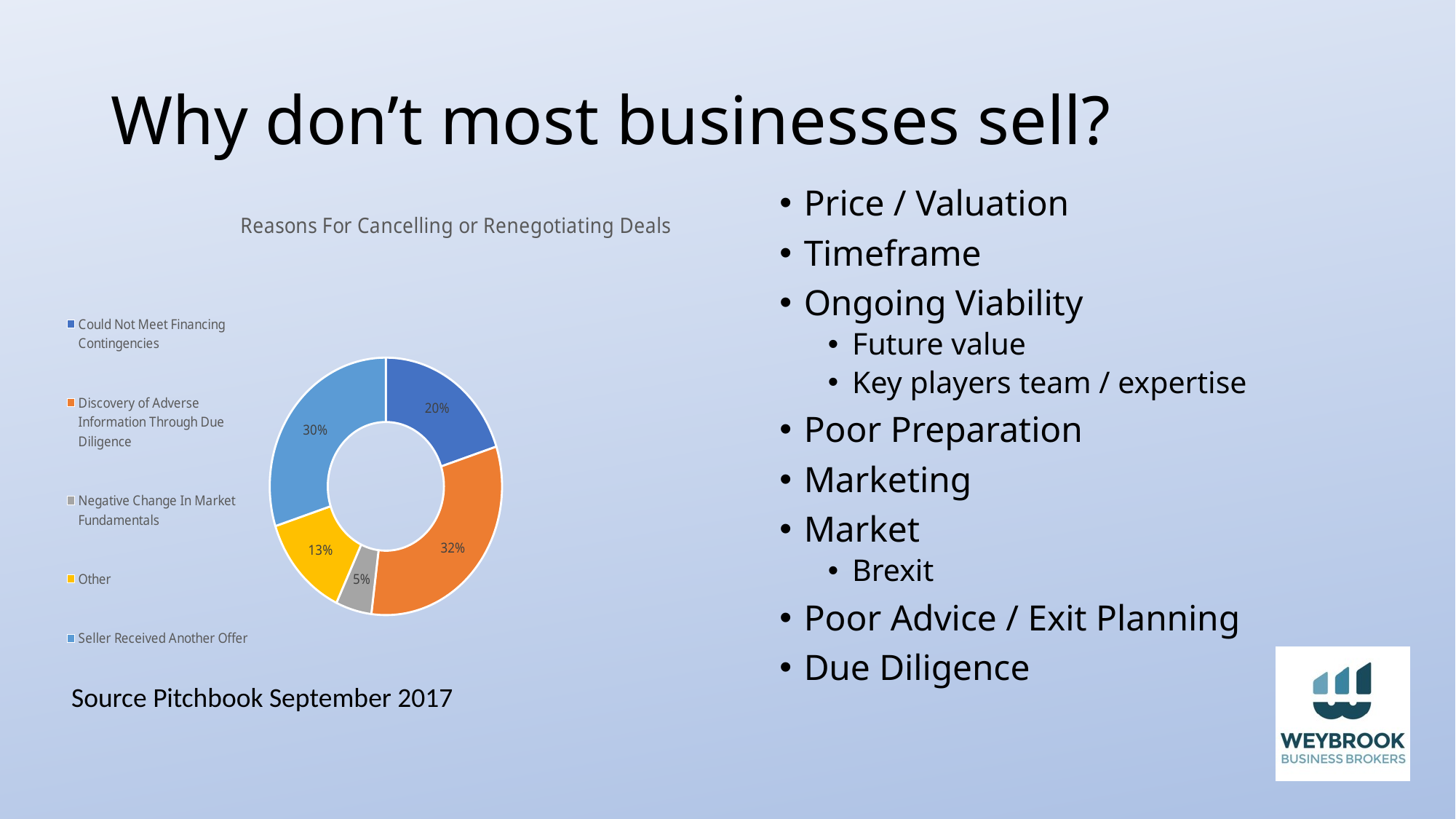
What percentage of the chart is attributed to Seller Received Another Offer? 30% What is the difference in percentage points between Discovery of Adverse Information Through Due Diligence and Could Not Meet Financing Contingencies? 12 Which is larger: the share for Other or the share for Negative Change In Market Fundamentals? Other What percentage of the chart is attributed to Other? 13% Which reason has the smallest share of the chart? Negative Change In Market Fundamentals What is the title of the chart? Reasons For Cancelling or Renegotiating Deals Which reason has the largest share of the chart? Discovery of Adverse Information Through Due Diligence How many categories does the chart show? 5 What percentage of the chart is attributed to Negative Change In Market Fundamentals? 5% What percentage of the chart is attributed to Could Not Meet Financing Contingencies? 20% What percentage of the chart is attributed to Discovery of Adverse Information Through Due Diligence? 32% What kind of chart is shown on the slide? Doughnut (pie) chart